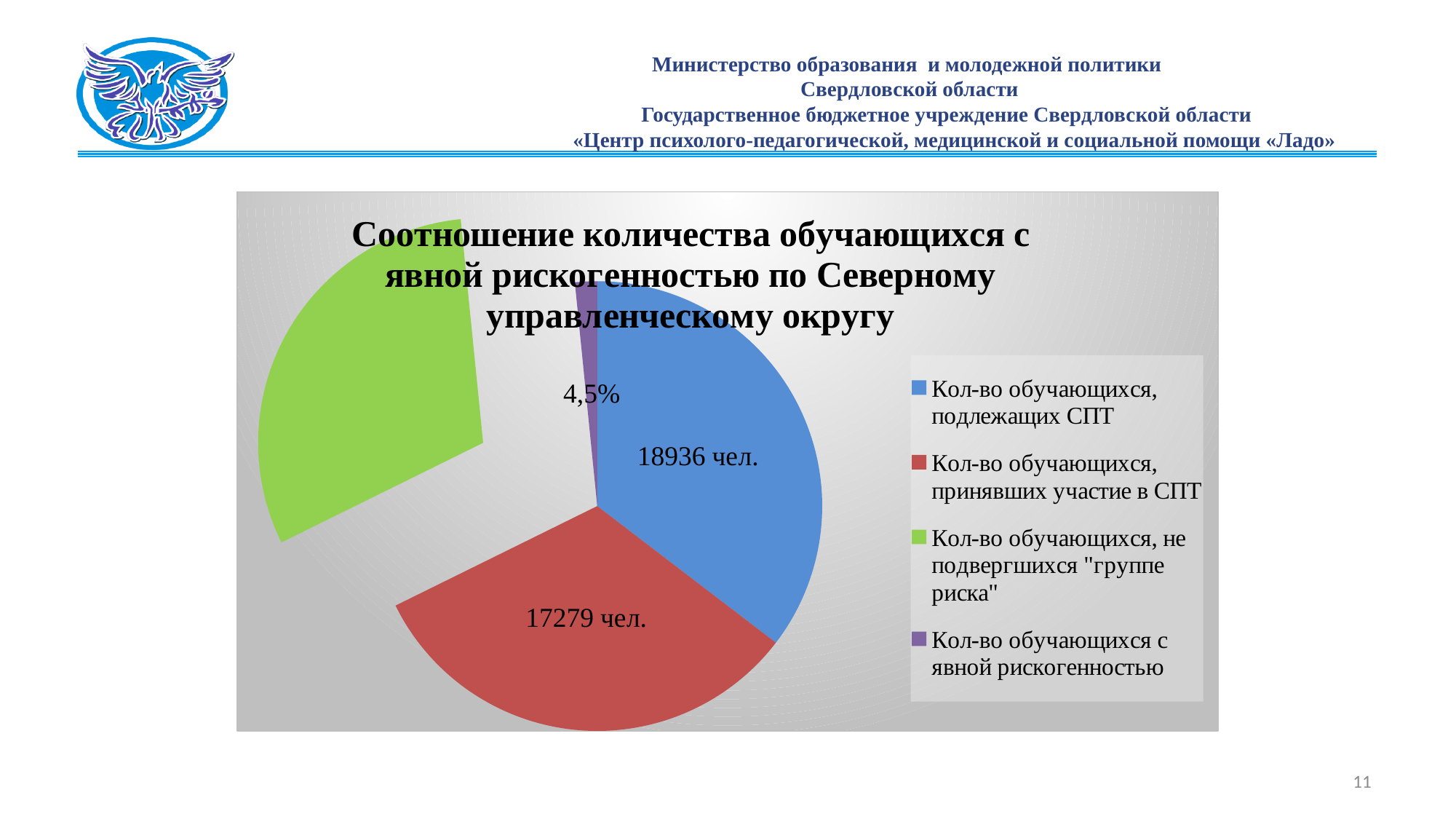
What value is shown for "Кол-во обучающихся, подлежащих СПТ"? 18936 чел. What is the difference between the values for "Кол-во обучающихся, подлежащих СПТ" and "Кол-во обучающихся, принявших участие в СПТ"? 1657 чел. What label is shown on the slice for "Кол-во обучающихся с явной рискогенностью"? 4,5% Which category has the smallest slice in the pie chart? Кол-во обучающихся с явной рискогенностью How many slices does the pie chart have? 4 How many entries does the legend of the pie chart list? 4 What value is shown for "Кол-во обучающихся, принявших участие в СПТ"? 17279 чел. What colour is the slice for "Кол-во обучающихся, не подвергшихся "группе риска""? green Which is larger: "Кол-во обучающихся, подлежащих СПТ" or "Кол-во обучающихся, принявших участие в СПТ"? Кол-во обучающихся, подлежащих СПТ What kind of chart is shown on the slide? pie chart What is the title of the pie chart? Соотношение количества обучающихся с явной рискогенностью по Северному управленческому округу